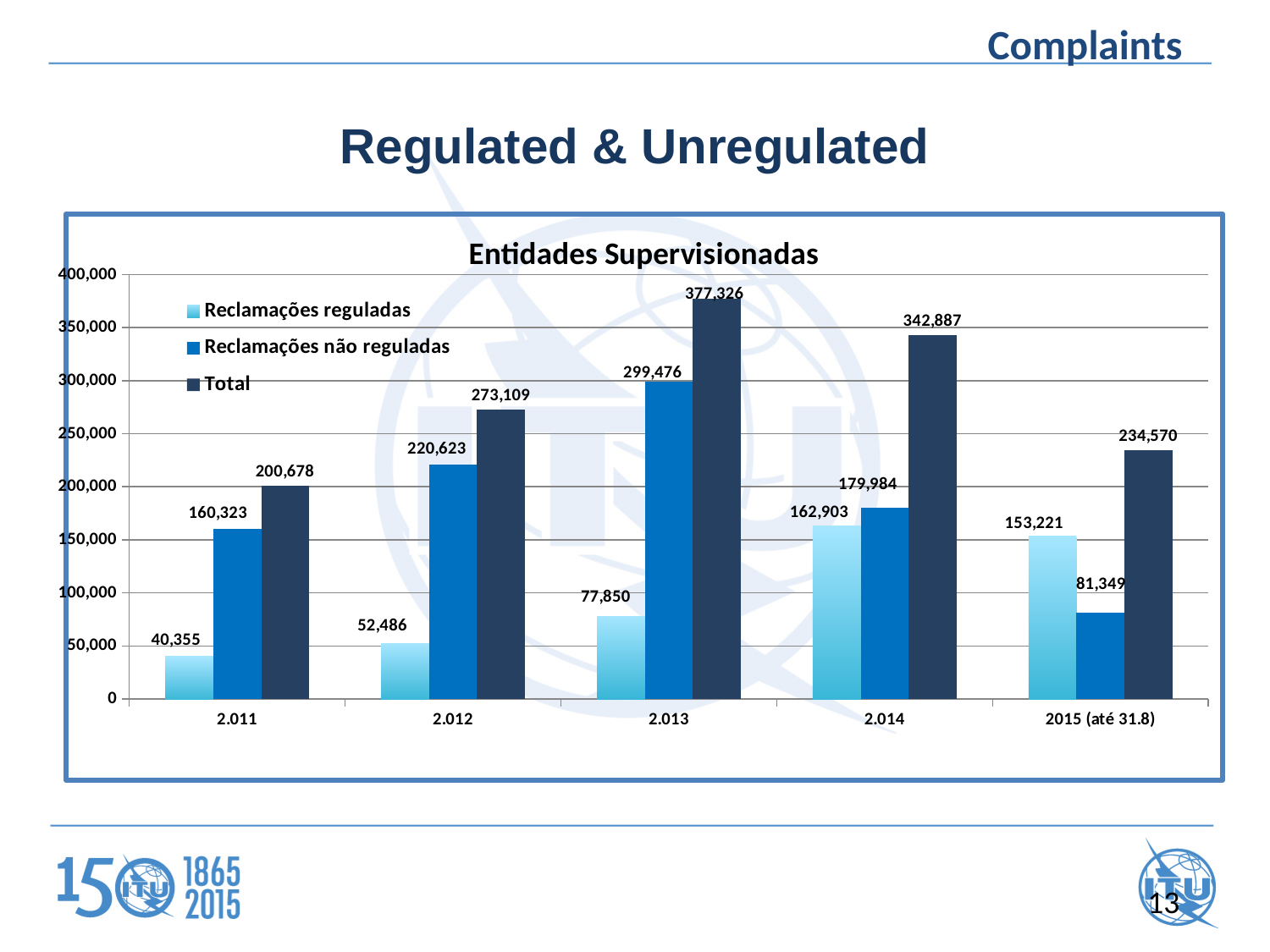
What is the value of Reclamações reguladas for 2.013? 77,850 Which is larger in 2015 (até 31.8): Reclamações reguladas or Reclamações não reguladas? Reclamações reguladas How many year categories are shown on the x axis? 5 What kind of chart is shown on the slide? Bar chart Is the value of Reclamações não reguladas for 2.012 greater or less than 200,000? greater What is the Total for 2.014? 342,887 How many series does the legend list? 3 What is the value of Reclamações não reguladas for 2015 (até 31.8)? 81,349 Which year has the highest Total? 2.013 What is the title of the chart? Entidades Supervisionadas What is the difference between the Total for 2.013 and the Total for 2.012? 104,217 Which year has the lowest value for Reclamações reguladas? 2.011